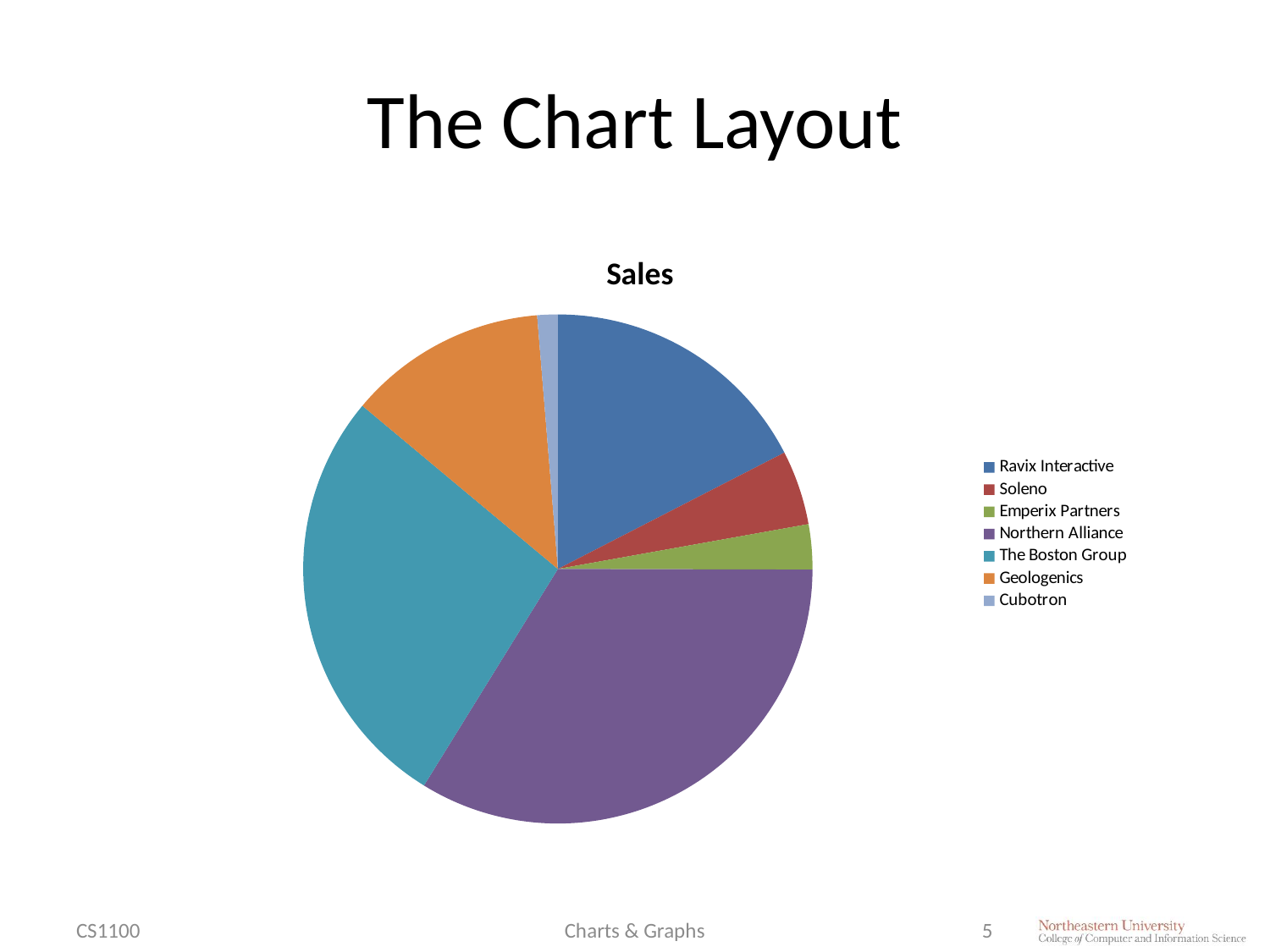
Which category has the smallest slice of the pie? Cubotron Which category is shown in purple in the pie chart? Northern Alliance Which slice is larger, Geologenics or Soleno? Geologenics Which category has the largest slice of the pie? Northern Alliance Which slice is larger, The Boston Group or Ravix Interactive? The Boston Group Which slice is larger, Northern Alliance or The Boston Group? Northern Alliance What kind of chart is shown on the slide? pie chart How many categories (slices) does the pie chart have? 7 What is the title of the chart? Sales